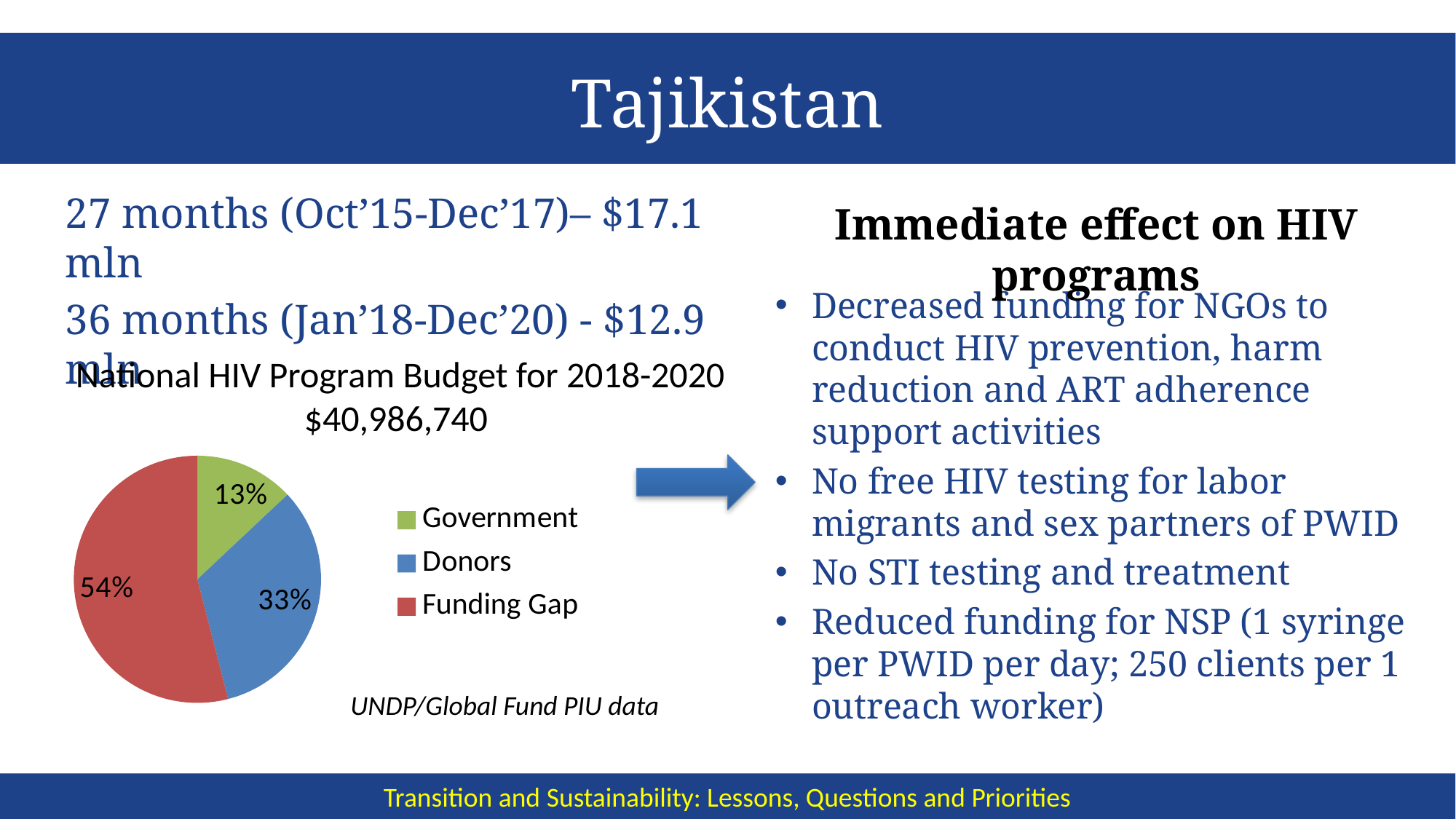
How many slices does the pie chart have? 3 What kind of chart is shown on the slide? pie chart What share of the pie does Donors represent? 33% What colour is the Funding Gap slice in the pie chart? red What is the difference in percentage points between the Funding Gap share and the Donors share? 21 What share of the pie does Funding Gap represent? 54% Which is larger, the Donors share or the Government share? Donors What share of the pie does Government represent? 13% Which slice of the pie is the largest? Funding Gap Which slice of the pie is the smallest? Government How many entries does the legend list? 3 What is the title of the pie chart? National HIV Program Budget for 2018-2020 $40,986,740